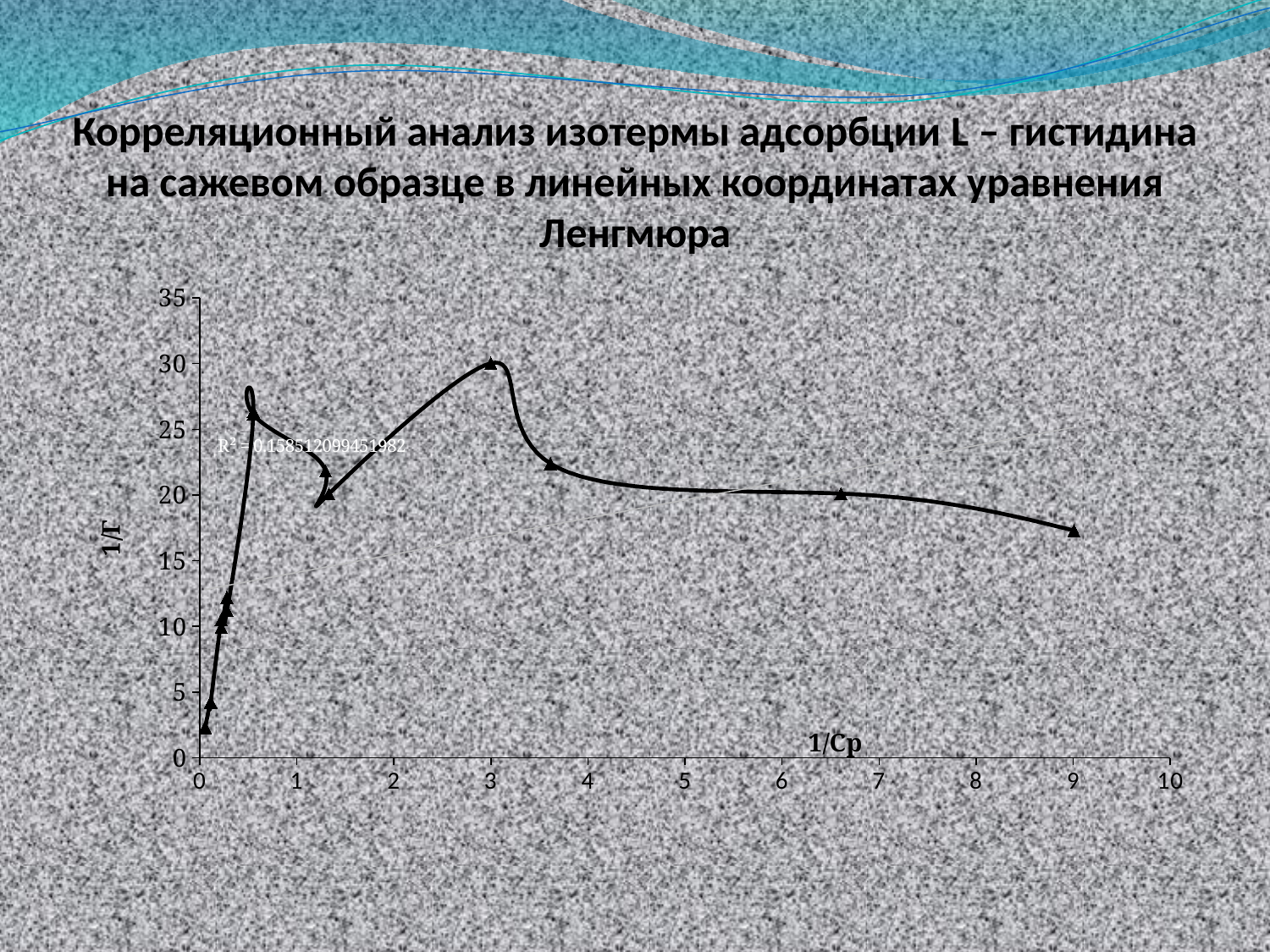
Is the value of 1/Г at 1/Cp ≈ 3 greater or less than 25? greater What kind of chart is shown on the slide? line chart What is the maximum value shown on the vertical axis? 35 Is the value of 1/Г at 1/Cp ≈ 9 greater or less than 20? less Which is larger: the value of 1/Г at 1/Cp ≈ 3 or at 1/Cp ≈ 9? at 1/Cp ≈ 3 Is the value of 1/Г at 1/Cp ≈ 6.6 greater or less than 25? less What is the label of the horizontal axis? 1/Cp What R² value is printed on the chart? R² = 0.158512099451982 Do the values of 1/Г rise or fall as 1/Cp increases from 3 to 9? fall What is the label of the vertical axis? 1/Г